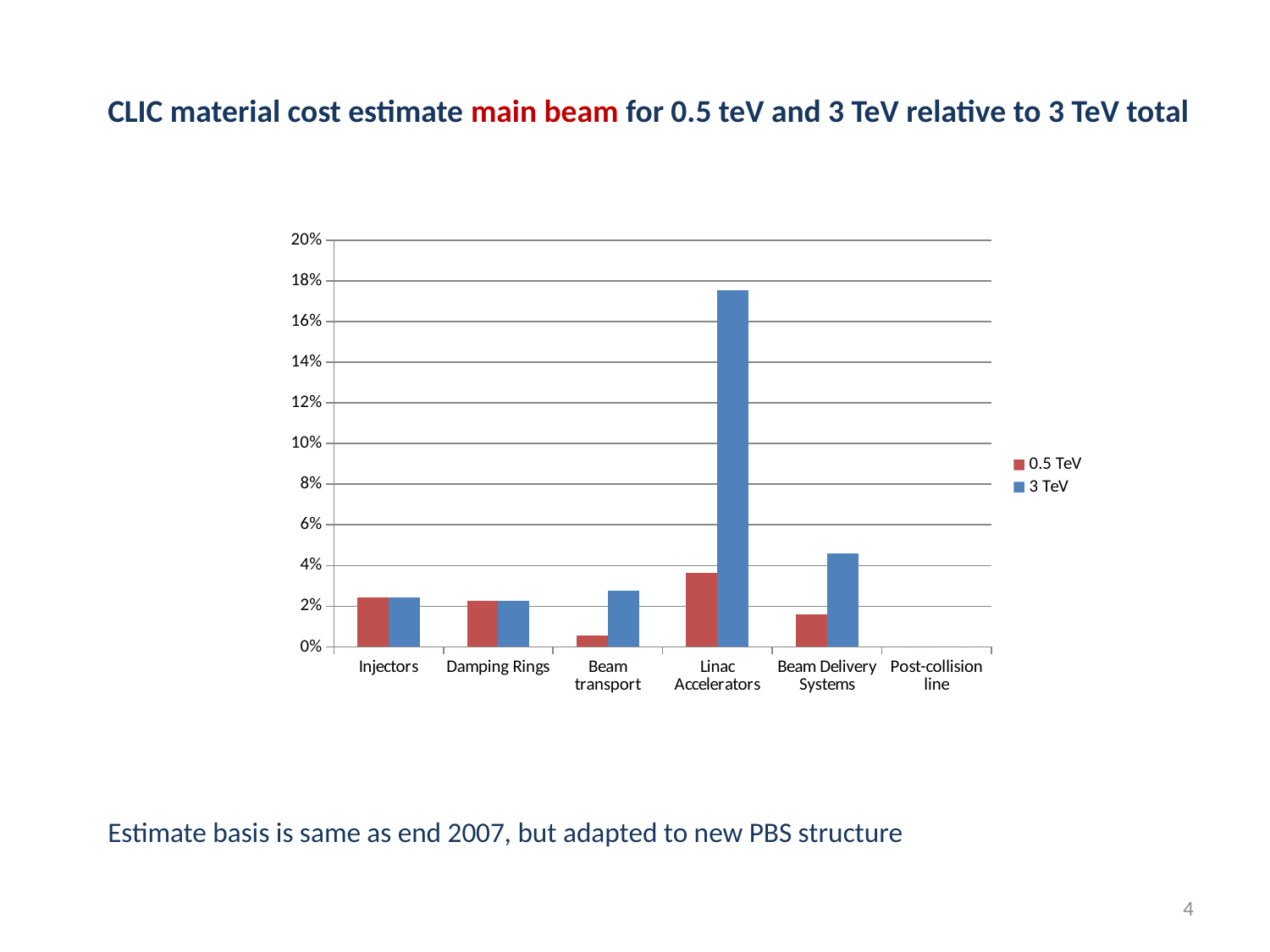
Is the 3 TeV value for Beam Delivery Systems greater or less than 4%? greater Is the 0.5 TeV value for Beam transport greater or less than 2%? less Which category has the highest value for the 0.5 TeV series? Linac Accelerators Which category has the highest value for the 3 TeV series? Linac Accelerators How many series does the legend list? 2 What kind of chart is shown on the slide? bar chart What are the two entries listed in the legend? 0.5 TeV and 3 TeV What colour are the bars for the 3 TeV series? blue How many categories are shown on the x axis? 6 For Beam transport, which series has the larger value, 0.5 TeV or 3 TeV? 3 TeV For Beam Delivery Systems, which series has the larger value, 0.5 TeV or 3 TeV? 3 TeV Is the 3 TeV value for Linac Accelerators greater or less than 16%? greater